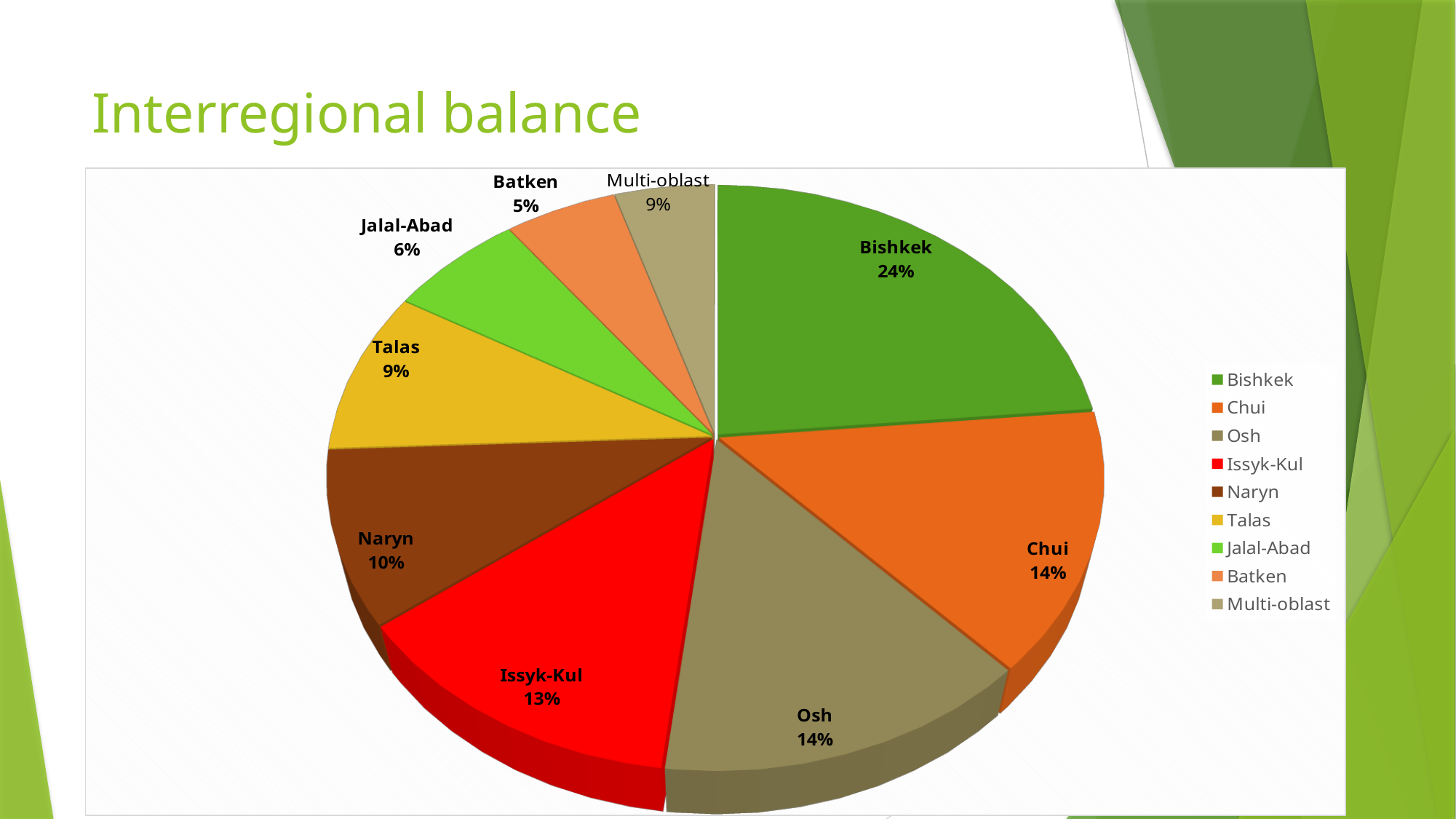
What kind of chart is shown on the slide? Pie chart Which region has the largest slice of the pie? Bishkek What is the value shown for Issyk-Kul? 13% Which is larger, the share for Naryn or the share for Jalal-Abad? Naryn What share of the pie does Bishkek have? 24% What colour is the Issyk-Kul slice in the legend? Red What is the value shown for Multi-oblast? 9% How many slices does the pie chart have? 9 What is the value shown for Naryn? 10% What is the difference between the shares of Bishkek and Chui? 10% What is the title of the slide containing the chart? Interregional balance